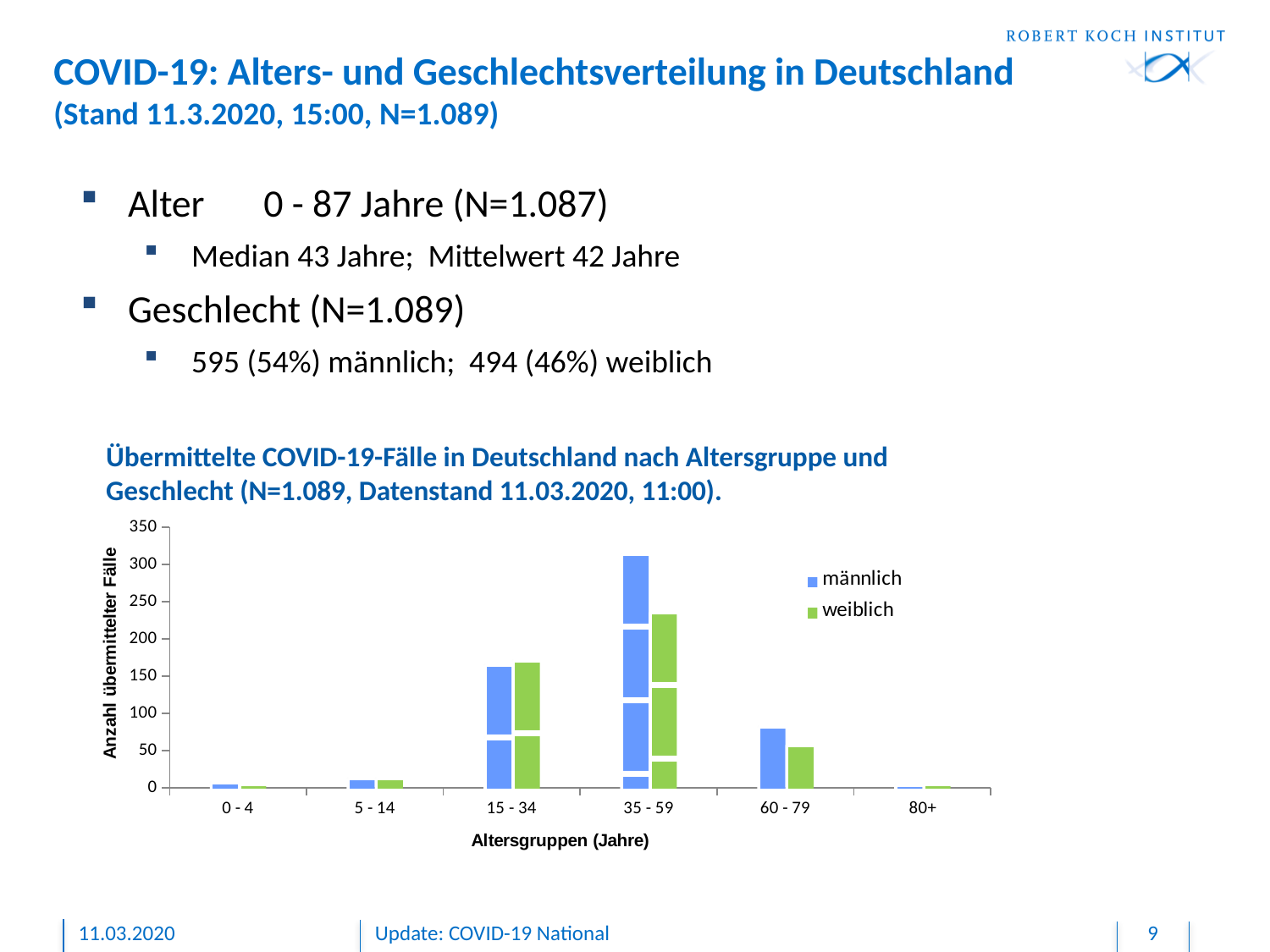
What kind of chart is shown on the slide? bar chart In the 60 - 79 age group, which is larger: männlich or weiblich? männlich How many series does the chart legend list? 2 How many age groups are shown on the x axis of the chart? 6 What is the label of the y axis of the chart? Anzahl übermittelter Fälle Is the value for männlich in the 35 - 59 age group greater or less than 250? greater Is the value for weiblich in the 35 - 59 age group greater or less than 200? greater In the 35 - 59 age group, which is larger: männlich or weiblich? männlich Which age group has the highest value for weiblich? 35 - 59 Which age group has the highest value for männlich? 35 - 59 Is the value for männlich in the 60 - 79 age group greater or less than 100? less Which colour represents the weiblich series in the chart? green